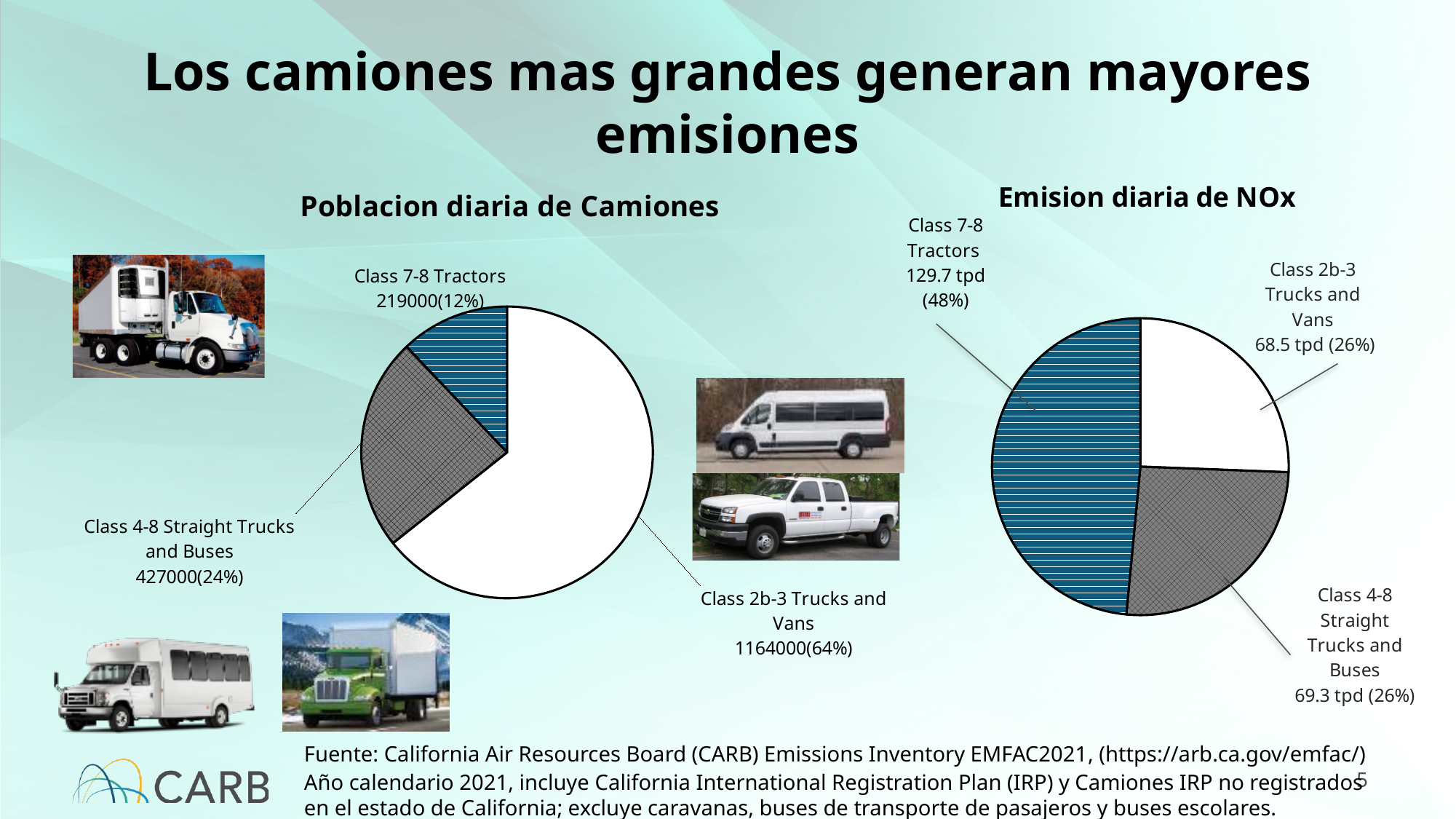
In the 'Poblacion diaria de Camiones' chart, what is the difference between Class 2b-3 Trucks and Vans and Class 4-8 Straight Trucks and Buses? 737000 In the 'Emision diaria de NOx' chart, what share of the pie do Class 4-8 Straight Trucks and Buses represent? 26% In the 'Poblacion diaria de Camiones' chart, what is the value for Class 4-8 Straight Trucks and Buses? 427000 (24%) In the 'Emision diaria de NOx' chart, what is the difference between Class 7-8 Tractors and Class 2b-3 Trucks and Vans? 61.2 tpd In the 'Poblacion diaria de Camiones' chart, what is the value for Class 7-8 Tractors? 219000 (12%) In the 'Emision diaria de NOx' chart, which category has the largest share? Class 7-8 Tractors What kind of chart is the 'Poblacion diaria de Camiones' chart? Pie chart In the 'Poblacion diaria de Camiones' chart, which category has the smallest share? Class 7-8 Tractors In the 'Poblacion diaria de Camiones' chart, what share of the pie do Class 2b-3 Trucks and Vans represent? 64% How many categories are shown in the 'Emision diaria de NOx' chart? 3 In the 'Poblacion diaria de Camiones' chart, which category has the largest share? Class 2b-3 Trucks and Vans In the 'Emision diaria de NOx' chart, what is the value for Class 7-8 Tractors? 129.7 tpd (48%)